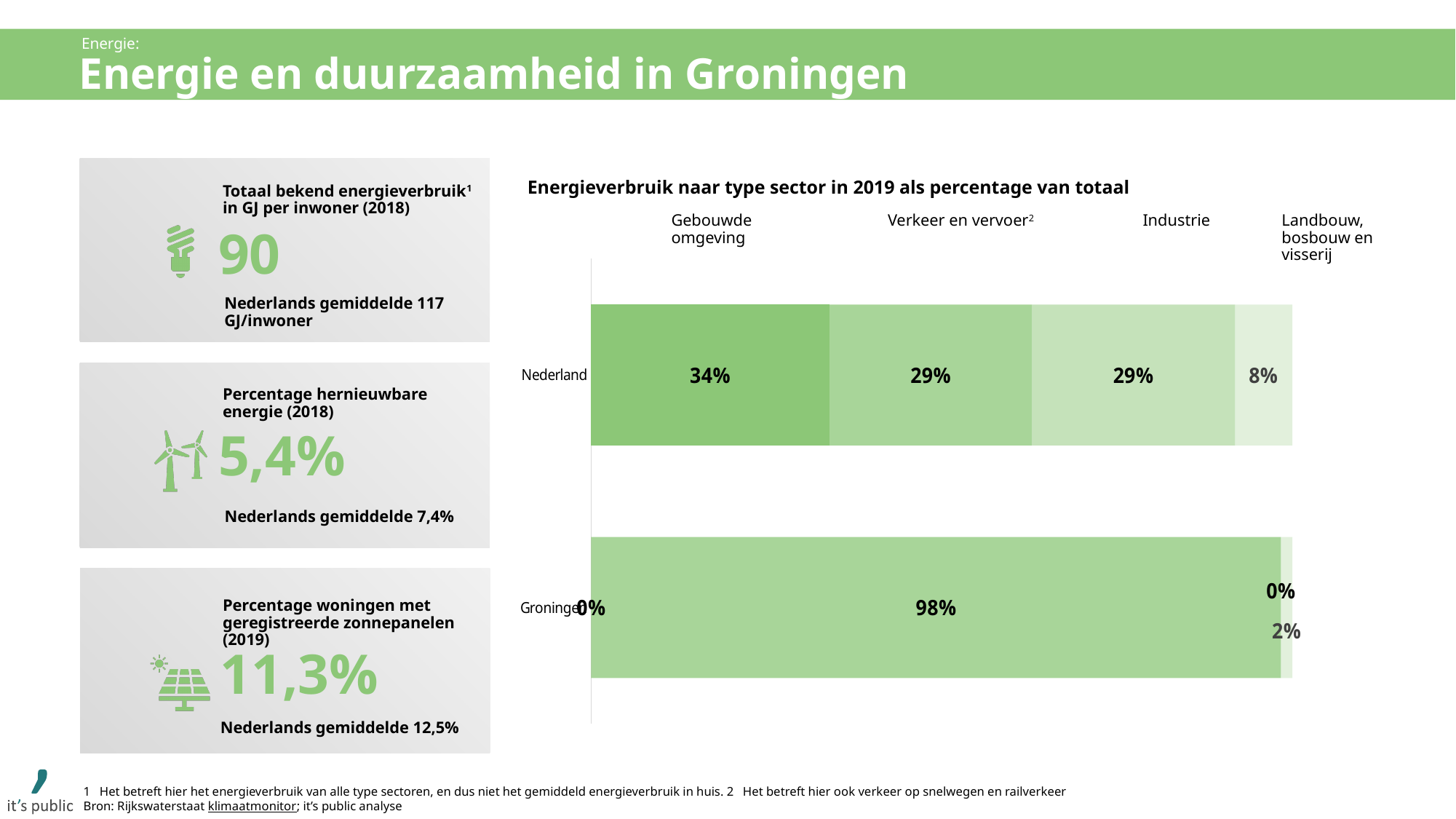
In the chart 'Energieverbruik naar type sector in 2019', what is the value for Verkeer en vervoer for Groningen? 98% How many regions (bars) are shown in the chart 'Energieverbruik naar type sector in 2019'? 2 In the chart 'Energieverbruik naar type sector in 2019', what is the value for Landbouw, bosbouw en visserij for Nederland? 8% In the chart 'Energieverbruik naar type sector in 2019', which is larger: the Gebouwde omgeving share for Nederland or the Verkeer en vervoer share for Nederland? Gebouwde omgeving In the chart 'Energieverbruik naar type sector in 2019', what is the value for Gebouwde omgeving for Nederland? 34% In the chart 'Energieverbruik naar type sector in 2019', what is the value for Landbouw, bosbouw en visserij for Groningen? 2% In the chart 'Energieverbruik naar type sector in 2019', what is the difference between the Verkeer en vervoer share for Groningen and for Nederland? 69 percentage points In the chart 'Energieverbruik naar type sector in 2019', which sector has the smallest share for Nederland? Landbouw, bosbouw en visserij What type of chart is used to show 'Energieverbruik naar type sector in 2019 als percentage van totaal'? Stacked bar chart How many sector series are shown in the chart 'Energieverbruik naar type sector in 2019'? 4 In the chart 'Energieverbruik naar type sector in 2019', which sector has the largest share for Nederland? Gebouwde omgeving In the chart 'Energieverbruik naar type sector in 2019', what is the value for Industrie for Nederland? 29%